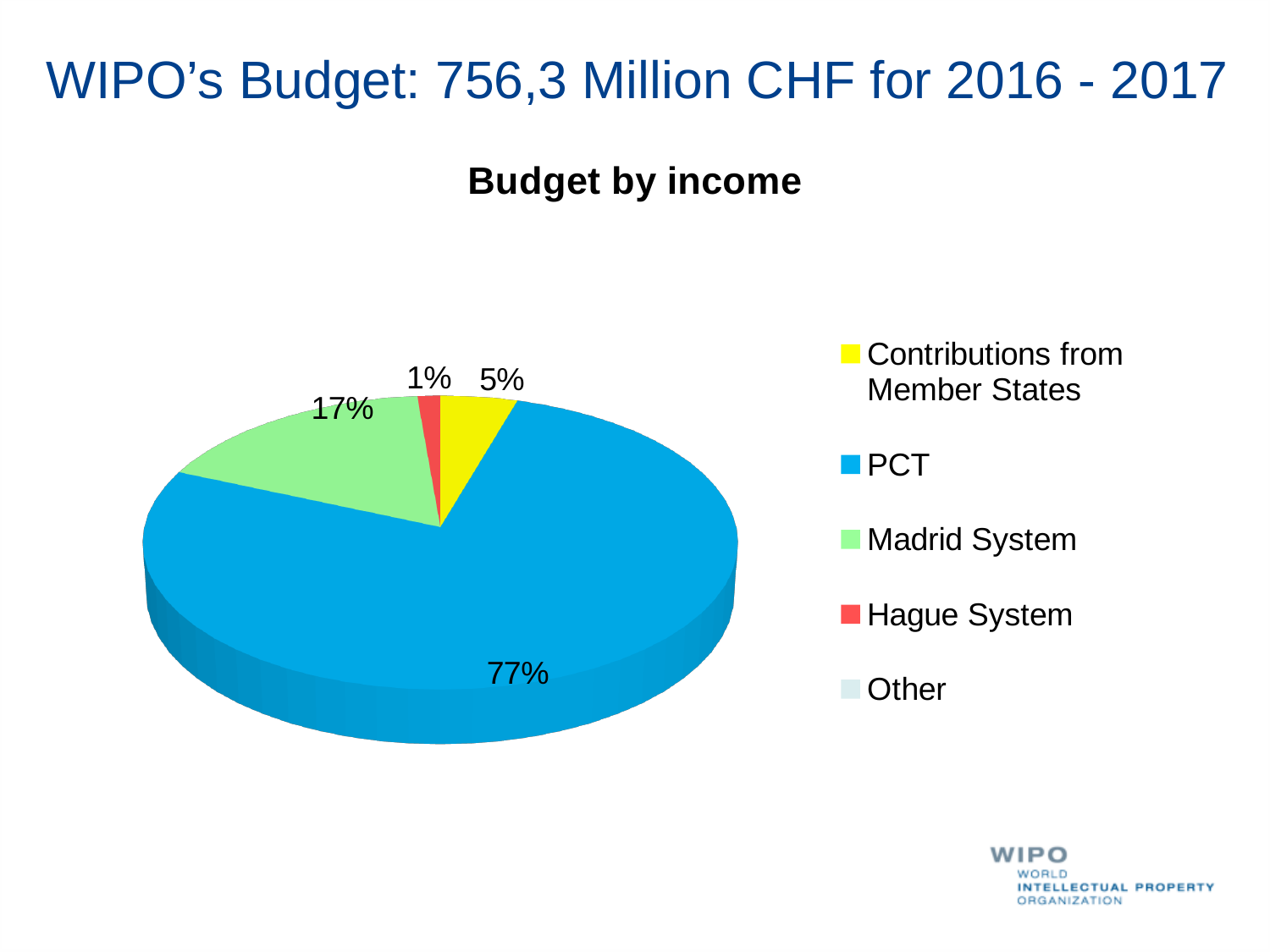
How many entries does the legend of the pie chart list? 5 What share of the budget by income comes from Contributions from Member States? 5% Which is larger: the share from Contributions from Member States or the share from the Hague System? Contributions from Member States What is the title of the chart on the slide? Budget by income How many percentage points larger is the PCT share than the Madrid System share? 60 What percentage of the budget by income is from the Madrid System? 17% What is the difference in percentage points between the Madrid System share and the Contributions from Member States share? 12 What kind of chart is shown on the slide? Pie chart Which labelled income source has the smallest share of the budget? Hague System Which income source has the largest share of the budget? PCT What share of the budget by income comes from PCT? 77% What percentage of the budget by income is from the Hague System? 1%